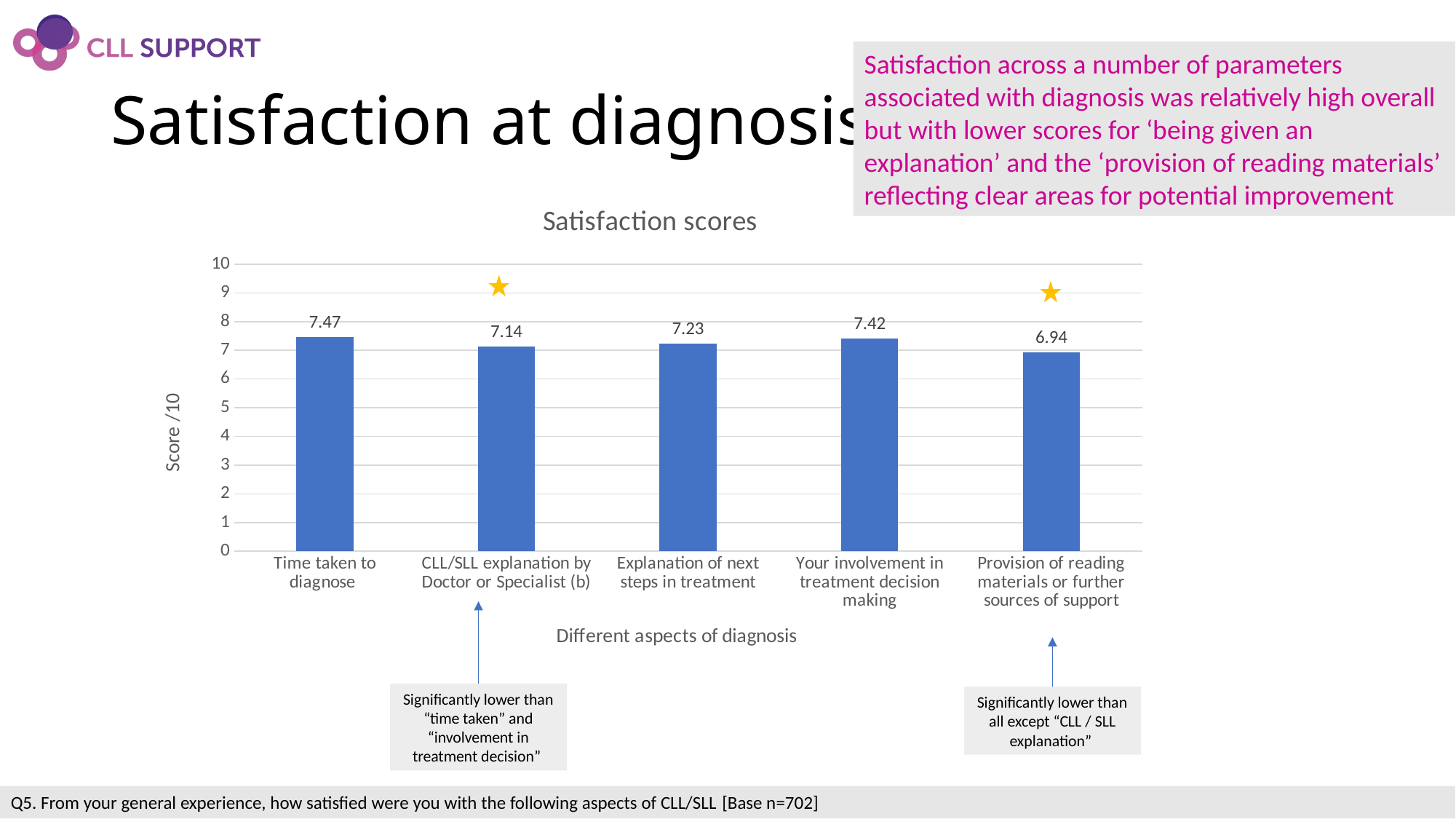
What is the difference between the satisfaction scores for 'Time taken to diagnose' and 'Provision of reading materials or further sources of support'? 0.53 Is the satisfaction score for 'Provision of reading materials or further sources of support' greater or less than 7? less Which aspect of diagnosis has the highest satisfaction score? Time taken to diagnose What is the title of the chart? Satisfaction scores What is the satisfaction score for 'Provision of reading materials or further sources of support'? 6.94 Which aspect of diagnosis has the lowest satisfaction score? Provision of reading materials or further sources of support What is the label of the vertical axis of the chart? Score /10 Which has a higher satisfaction score: 'CLL/SLL explanation by Doctor or Specialist (b)' or 'Your involvement in treatment decision making'? Your involvement in treatment decision making How many aspects of diagnosis are shown in the chart? 5 What is the satisfaction score for 'Explanation of next steps in treatment'? 7.23 What is the satisfaction score for 'Time taken to diagnose'? 7.47 What type of chart is used to show the satisfaction scores? Bar chart